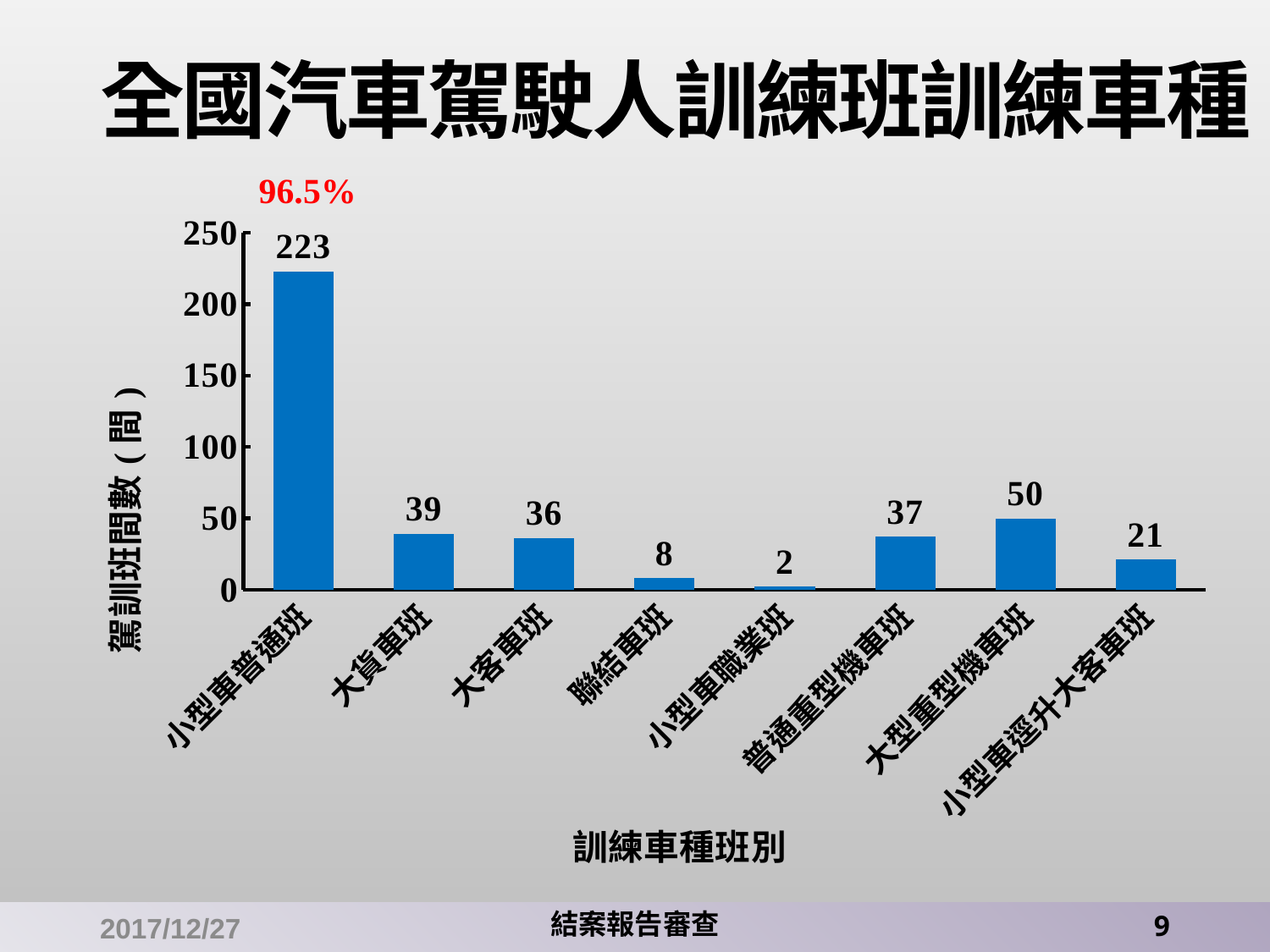
Is the value for 小型車普通班 greater or less than 200? greater How many categories are shown on the x axis? 8 What is the difference between the values for 大貨車班 and 大客車班? 3 Which category has the highest value? 小型車普通班 Which category has the lowest value? 小型車職業班 What kind of chart is shown on the slide? bar chart What is the value for 小型車普通班? 223 Which is larger, the value for 聯結車班 or the value for 小型車逕升大客車班? 小型車逕升大客車班 What is the value for 小型車逕升大客車班? 21 What is the value for 大型重型機車班? 50 What percentage is annotated in red above the 小型車普通班 bar? 96.5% What is the difference between the values for 大型重型機車班 and 普通重型機車班? 13